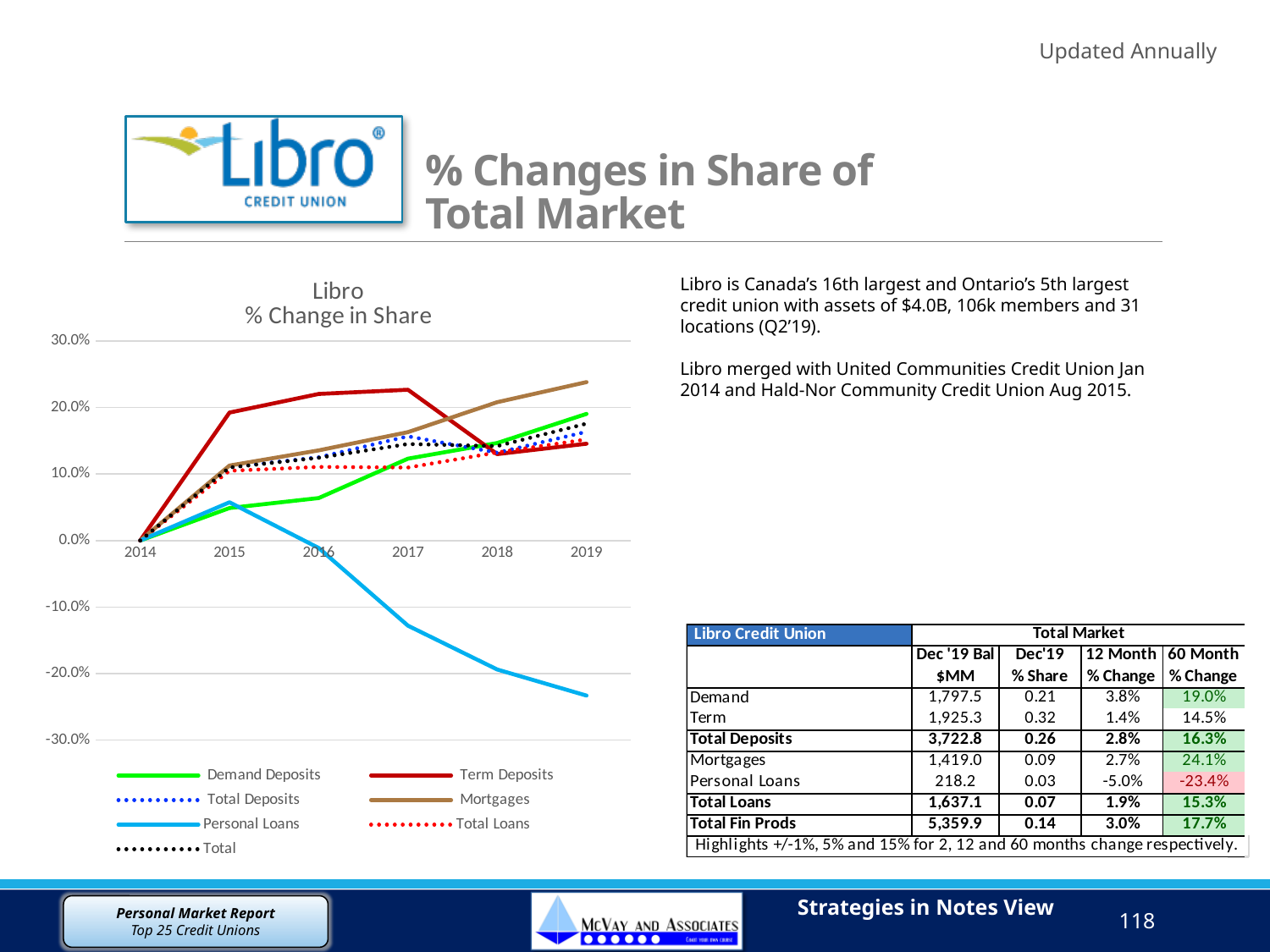
In 2017, which is larger: Term Deposits or Demand Deposits? Term Deposits Is the value for Personal Loans in 2019 greater or less than -20.0%? less Does the Personal Loans line rise or fall from 2015 to 2019? fall Is the value for Term Deposits in 2017 greater or less than 20.0%? greater What is the title of the chart? Libro % Change in Share How many years are plotted along the x axis of the chart? 6 Which series has the lowest value in 2019? Personal Loans Is the value for Mortgages in 2019 greater or less than 20.0%? greater What kind of chart is shown on the slide? line chart Which series has the highest value in 2019? Mortgages How many series does the legend of the chart list? 7